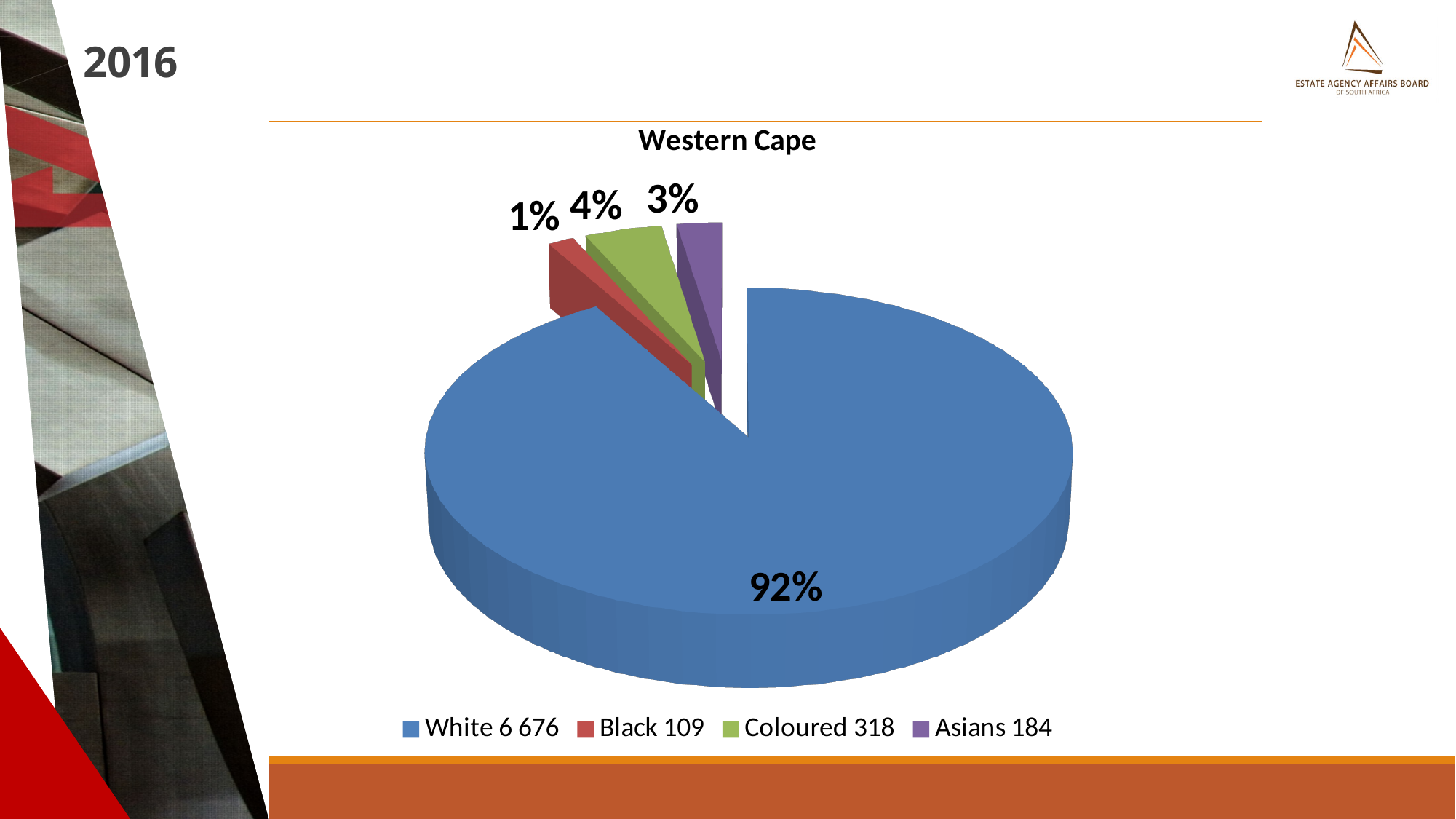
Which category has the largest slice of the pie? White Which category has the smallest slice of the pie? Black What share of the pie does the Black category represent? 1% What number is shown for Coloured in the legend? 318 How many categories does the pie chart show? 4 What number is shown for White in the legend? 6 676 What is the title of the chart? Western Cape What share of the pie does the Asians category represent? 3% What is the difference between the Coloured and Asians values shown in the legend? 134 What type of chart is shown on the slide? pie chart What share of the pie does the White category represent? 92%